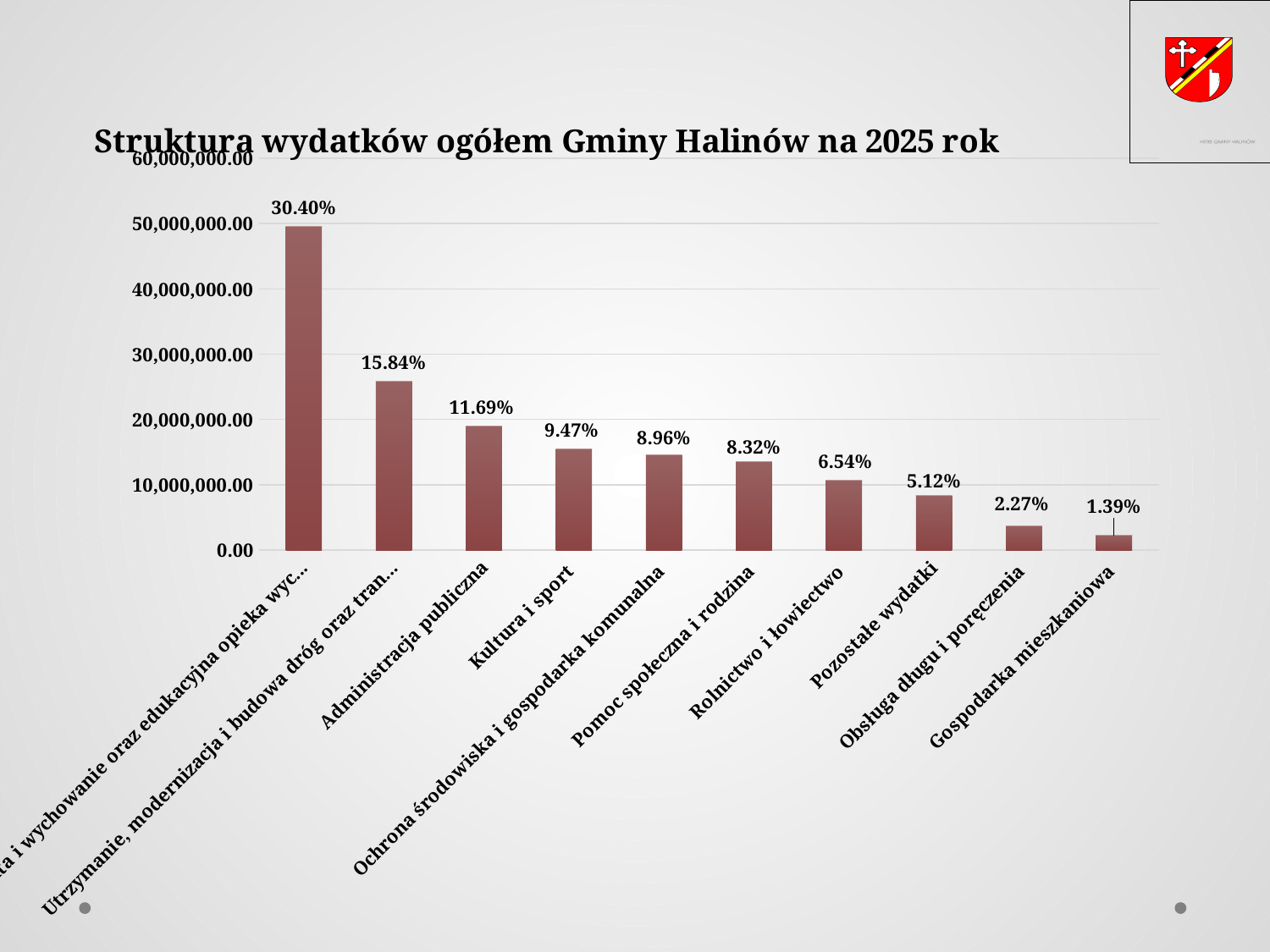
Which category has the lowest bar in the chart? Gospodarka mieszkaniowa What is the difference between the percentage labels for Kultura i sport and Ochrona środowiska i gospodarka komunalna? 0.51% Which has the larger bar: Pomoc społeczna i rodzina or Rolnictwo i łowiectwo? Pomoc społeczna i rodzina What percentage label is shown above the bar for Administracja publiczna? 11.69% How many categories (bars) are shown in the chart? 10 Do the bar values rise or fall from left to right along the x axis? Fall What kind of chart is shown on the slide? Bar chart What percentage label is shown above the bar for Gospodarka mieszkaniowa? 1.39% What percentage label is shown above the bar for Obsługa długu i poręczenia? 2.27% Is the value for Administracja publiczna greater or less than 20,000,000.00? less Is the value for Kultura i sport greater or less than 10,000,000.00? greater What percentage label is shown above the bar for Kultura i sport? 9.47%